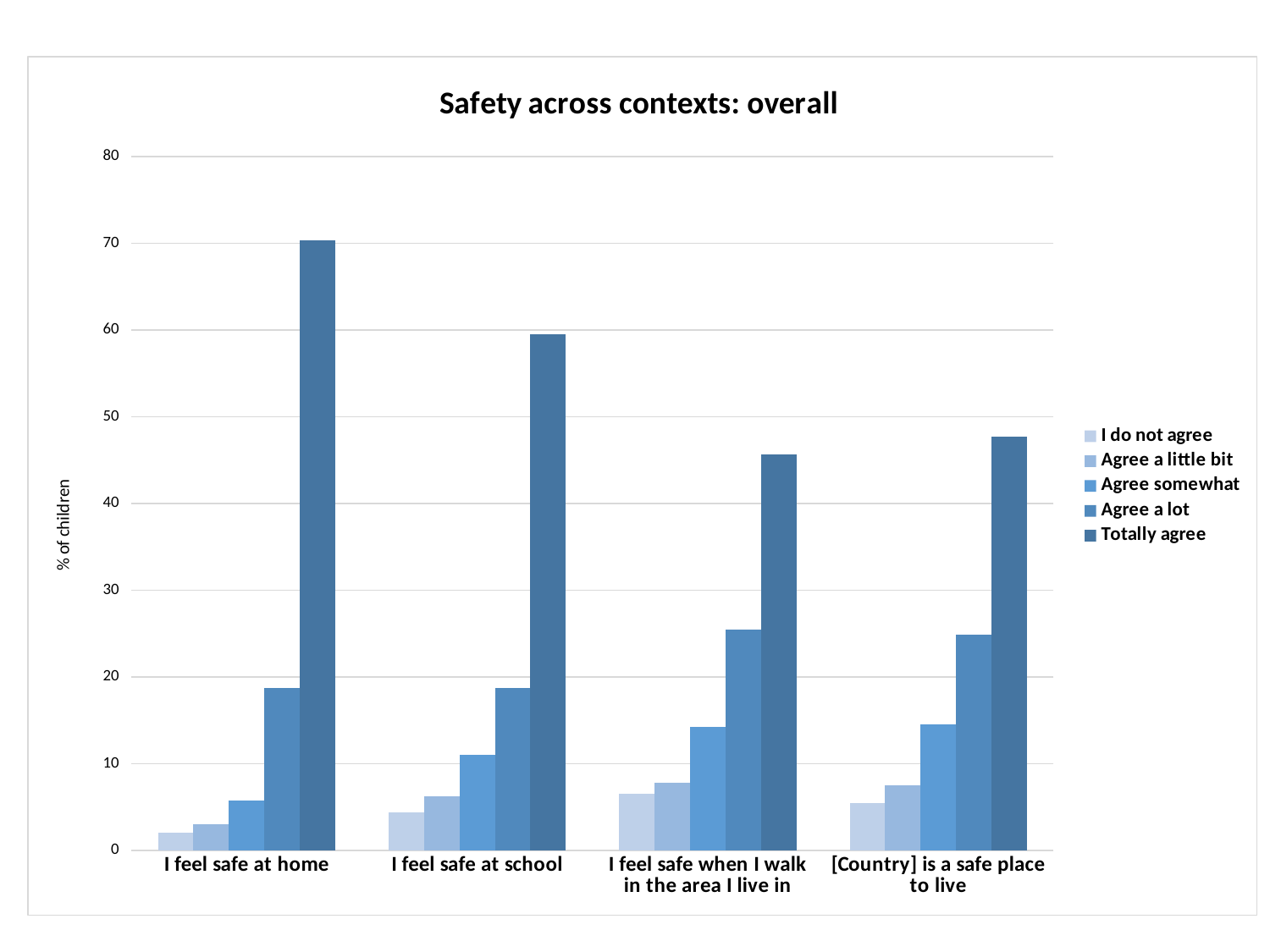
Is the 'Totally agree' value for '[Country] is a safe place to live' greater or less than 50? less Is the 'Totally agree' value for 'I feel safe at school' greater or less than 70? less Is the 'Totally agree' value for 'I feel safe at home' greater or less than 60? greater What kind of chart is shown on the slide? bar chart How many statement categories are shown on the x axis? 4 How many series does the legend list? 5 For which statement is the 'I do not agree' bar lowest? I feel safe at home What is the title of the chart? Safety across contexts: overall Which has the larger 'Totally agree' value: 'I feel safe at home' or 'I feel safe at school'? I feel safe at home What is the label on the vertical axis? % of children For which statement is the 'Totally agree' bar highest? I feel safe at home